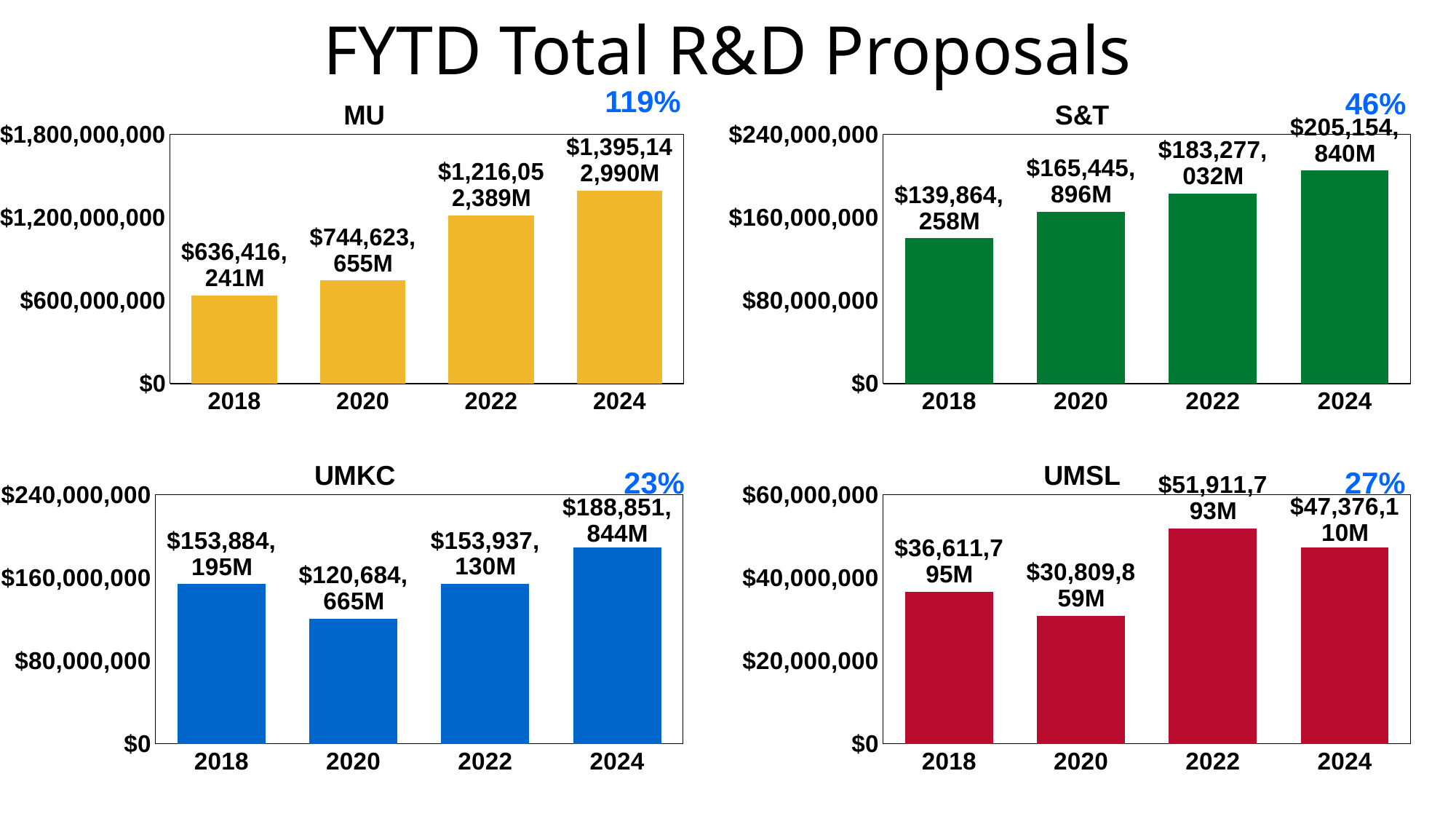
On the UMSL chart, which year has the highest value? 2022 On the UMSL chart, what is the value for 2022? $51,911,793M On the UMSL chart, which is larger, the value for 2018 or the value for 2020? 2018 On the S&T chart, what is the value for 2018? $139,864,258M On the MU chart, what is the value for 2024? $1,395,142,990M How many years are shown on the MU chart? 4 On the UMKC chart, what is the value for 2020? $120,684,665M On the UMKC chart, which year has the lowest value? 2020 On the S&T chart, what is the difference between the 2024 and 2018 values? $65,290,582M On the UMKC chart, is the value for 2020 greater or less than $160,000,000? less What kind of chart is the S&T chart? bar chart On the MU chart, do the values rise or fall from 2018 to 2024? rise